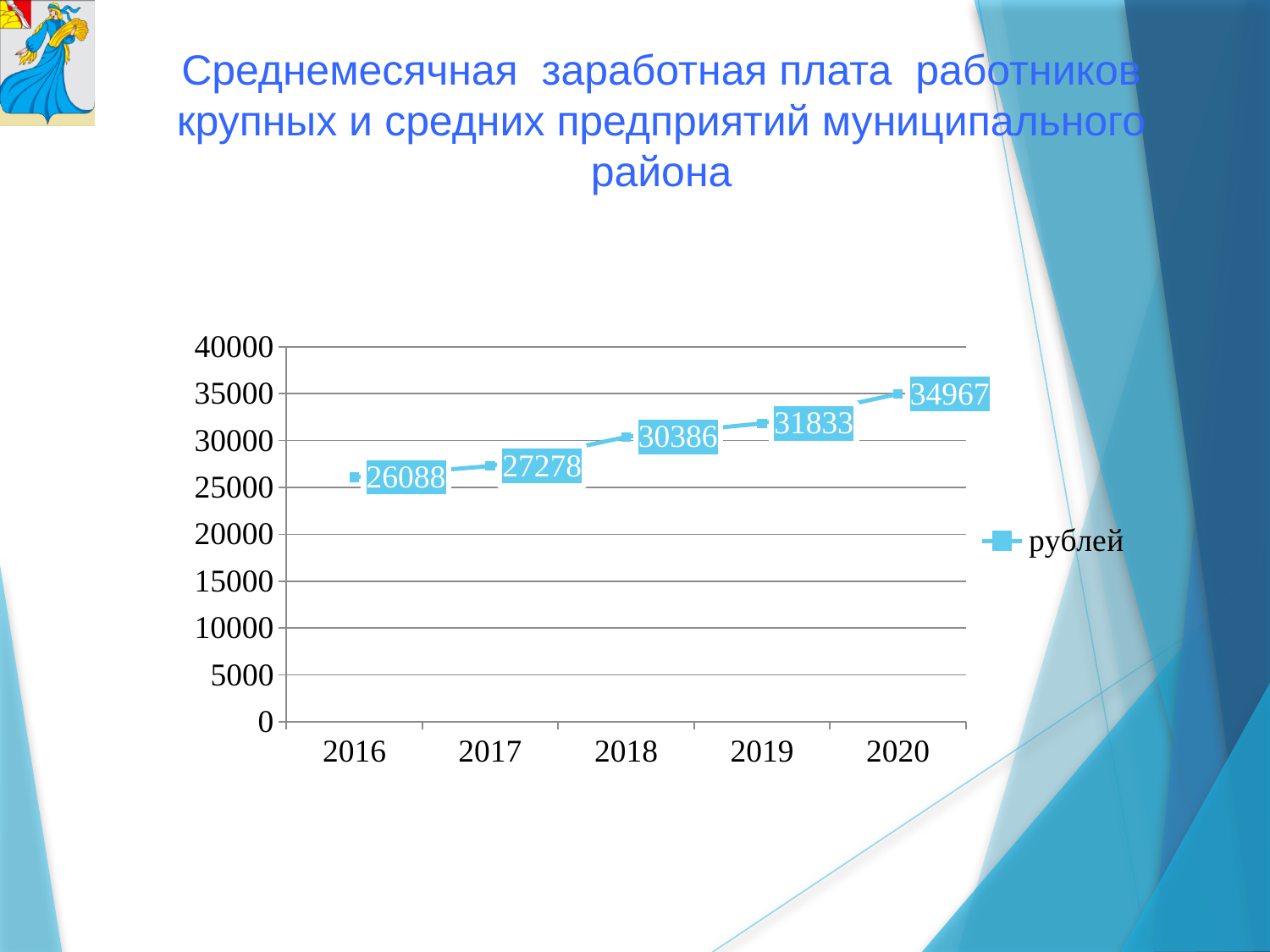
What is the value for 2018? 30386 What kind of chart is shown on the slide? line chart Do the values rise or fall from 2016 to 2020? rise Is the value for 2017 greater or less than 30000? less What is the difference between the values for 2020 and 2016? 8879 What is the value for 2016? 26088 What is the value for 2020? 34967 What is the difference between the values for 2019 and 2018? 1447 Which is larger, the value for 2017 or the value for 2019? 2019 Which year has the highest value? 2020 How many years are plotted on the chart? 5 Which year has the lowest value? 2016